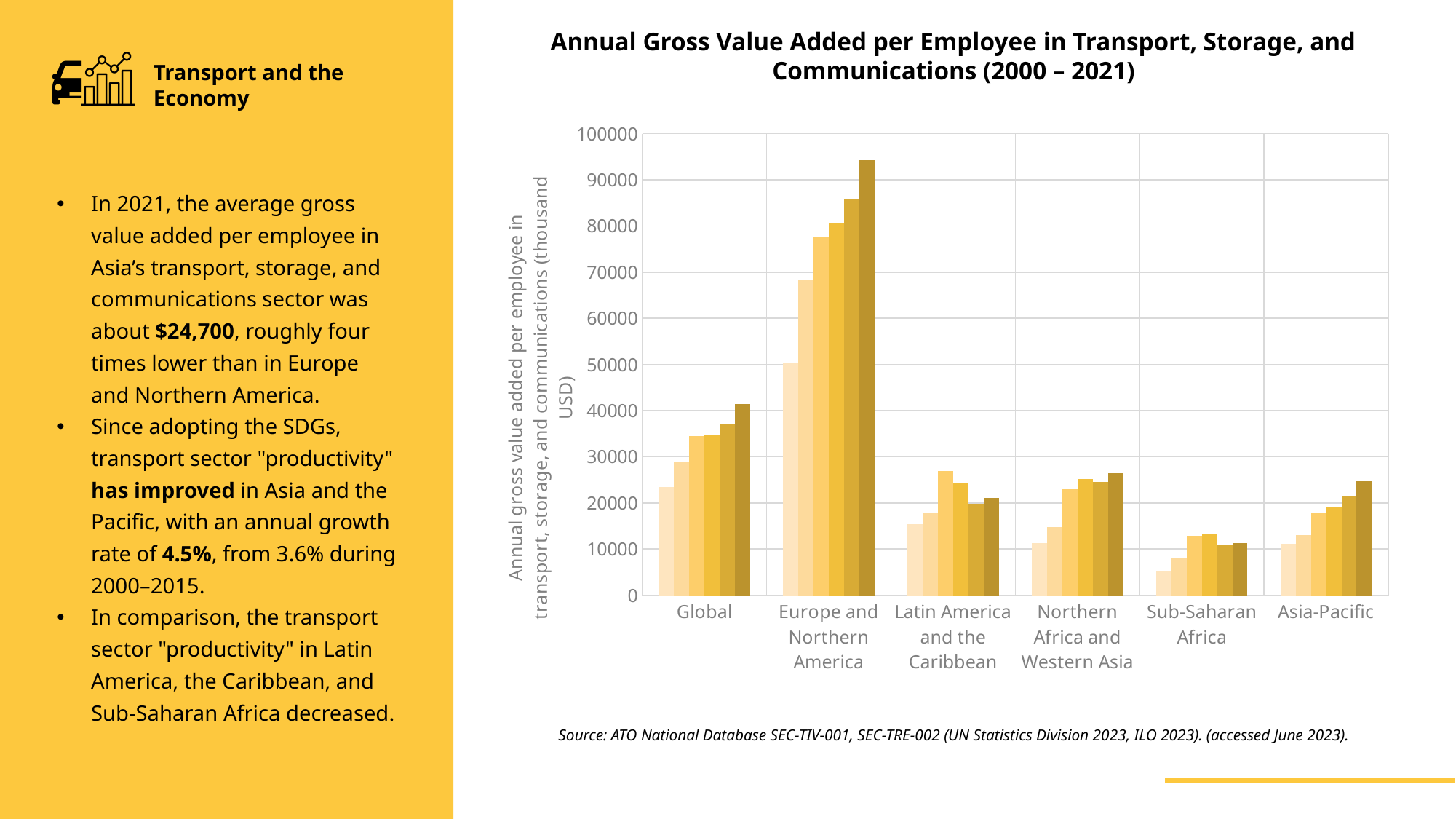
Is the tallest bar for Europe and Northern America greater or less than 90000? greater What kind of chart is shown on the slide? Bar chart Which region has the lowest bars in the chart? Sub-Saharan Africa Do the bars for Europe and Northern America rise or fall from left to right within the group? Rise Which region has the highest annual gross value added per employee in the chart? Europe and Northern America Is the tallest bar for Latin America and the Caribbean greater or less than 30000? less How many regional categories are shown on the x axis of the chart? 6 Is the tallest bar for Sub-Saharan Africa greater or less than 20000? less Which region has a taller tallest bar, Asia-Pacific or Sub-Saharan Africa? Asia-Pacific How many bars are plotted for each region in the chart? 6 What is the title of the chart? Annual Gross Value Added per Employee in Transport, Storage, and Communications (2000 – 2021)